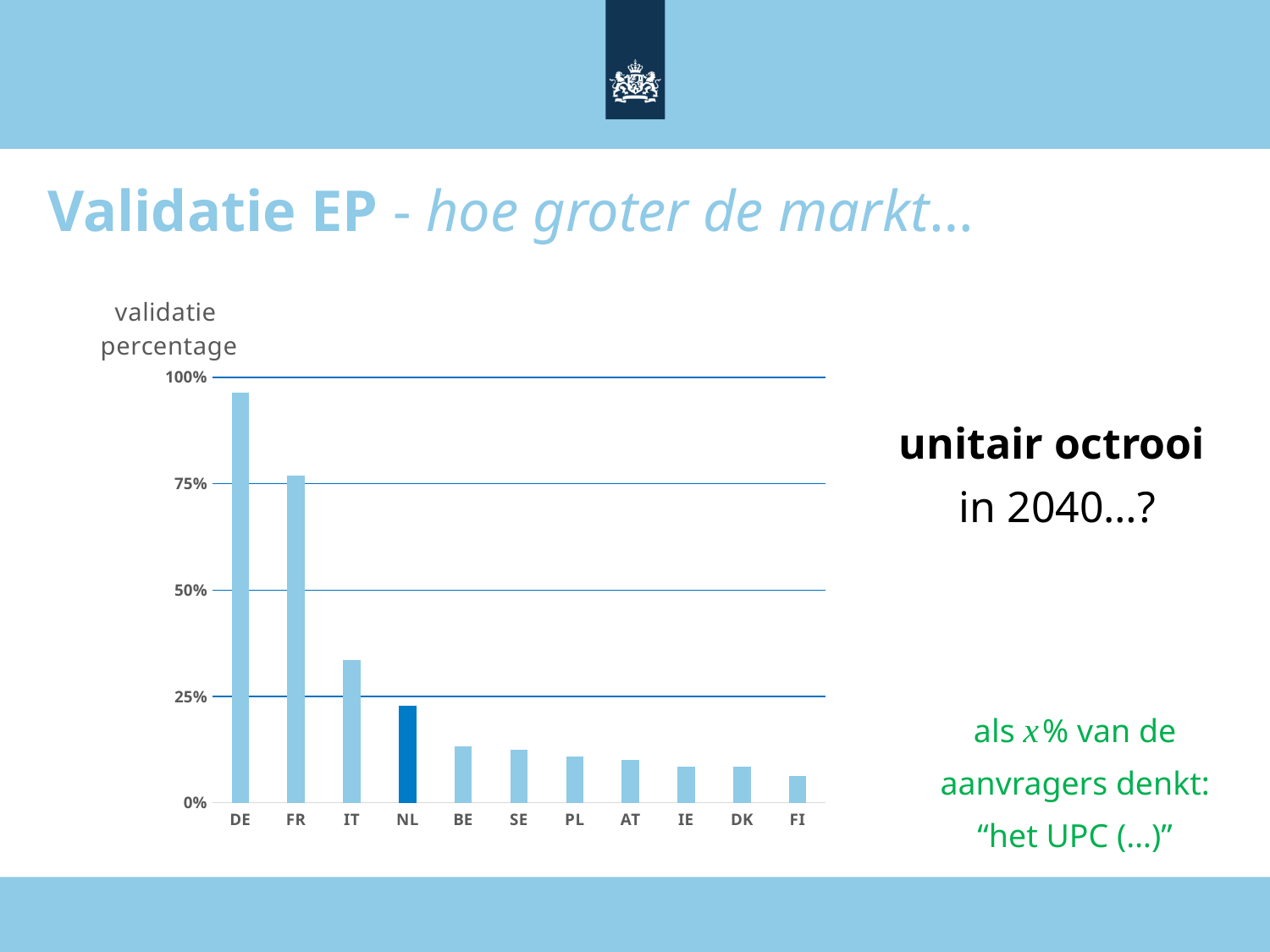
Is the value for IT greater or less than 25%? greater Which country has the highest validation percentage in the chart? DE Do the values rise or fall moving from left to right along the x axis? fall Is the value for BE greater or less than 25%? less Is the value for DE greater or less than 75%? greater Which country has the lowest validation percentage in the chart? FI How many countries are shown on the x axis of the chart? 11 Which country's bar is shown in a darker blue than the others? NL Which has a higher validation percentage, IT or NL? IT What kind of chart is shown on the slide? bar chart